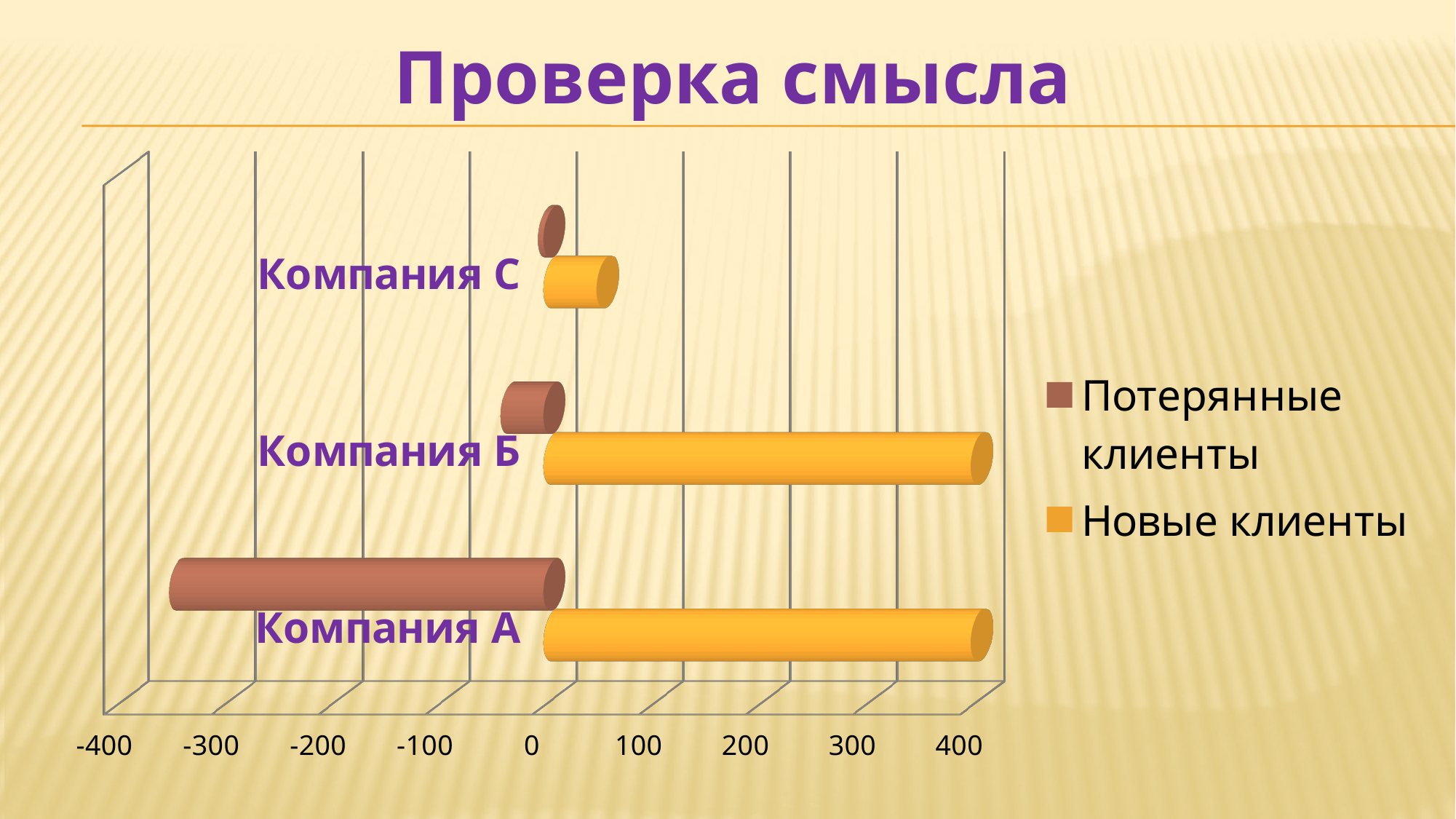
Is the value of Новые клиенты for Компания С greater or less than 100? less What is the title of the slide? Проверка смысла How many companies are shown on the chart? 3 Which company has the lowest value for Новые клиенты? Компания С Is the value of Новые клиенты for Компания А greater or less than 300? greater Is the value of Потерянные клиенты for Компания А greater or less than -300? less Which colour represents Новые клиенты in the legend? yellow How many series does the legend list? 2 Which company has the lowest (most negative) value for Потерянные клиенты? Компания А Which has the larger value for Новые клиенты, Компания Б or Компания С? Компания Б What kind of chart is shown on the slide? bar chart